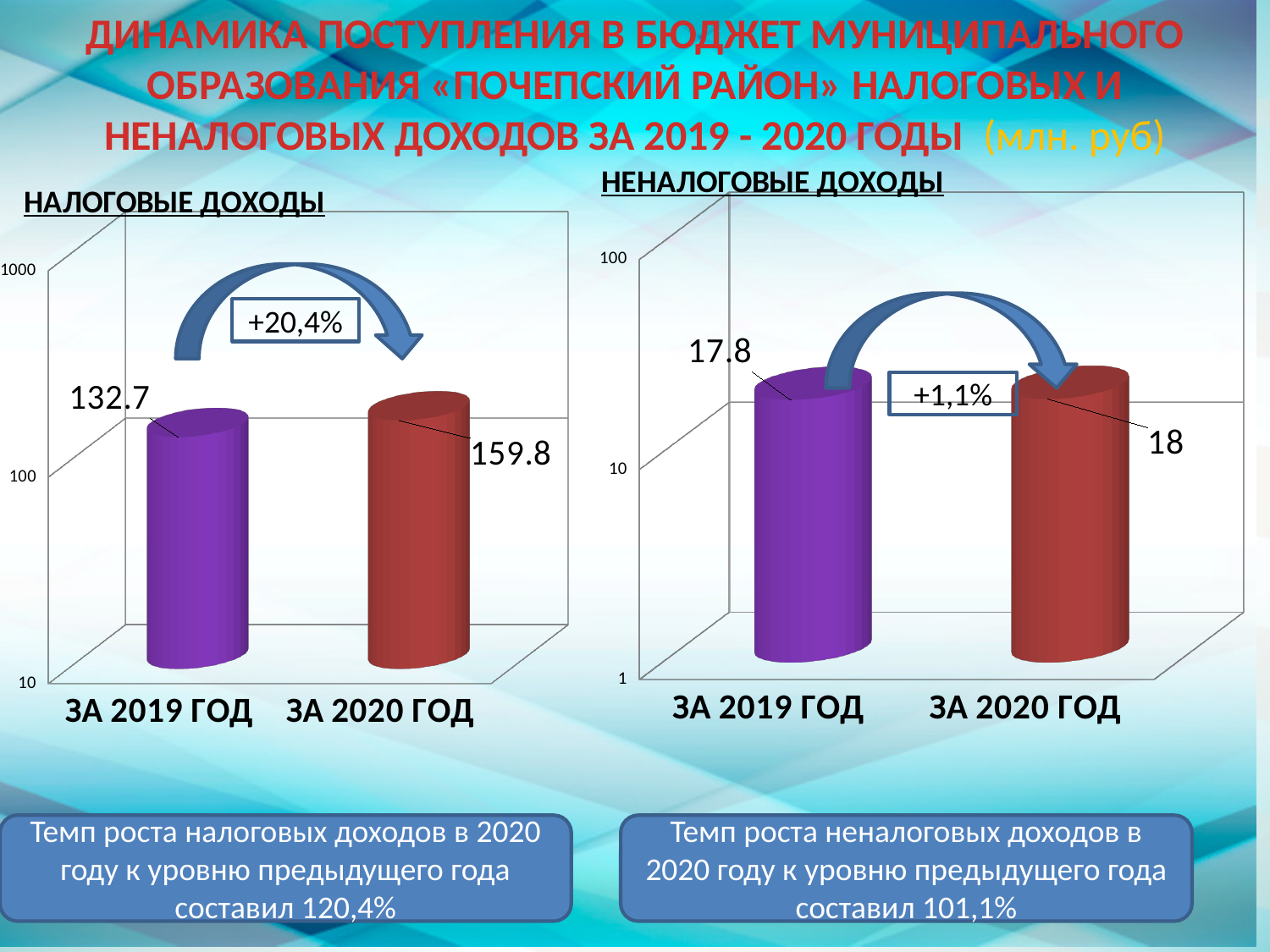
In the НЕНАЛОГОВЫЕ ДОХОДЫ chart, what is the value for ЗА 2020 ГОД? 18 How many bars are shown in the НЕНАЛОГОВЫЕ ДОХОДЫ chart? 2 In the НАЛОГОВЫЕ ДОХОДЫ chart, do the values rise or fall from 2019 to 2020? rise In the НЕНАЛОГОВЫЕ ДОХОДЫ chart, what is the difference between the values for ЗА 2020 ГОД and ЗА 2019 ГОД? 0.2 What kind of chart is the НАЛОГОВЫЕ ДОХОДЫ chart? bar chart In the НАЛОГОВЫЕ ДОХОДЫ chart, is the value for ЗА 2019 ГОД greater or less than 100? greater What percentage change is shown on the arrow in the НЕНАЛОГОВЫЕ ДОХОДЫ chart? +1,1% In the НАЛОГОВЫЕ ДОХОДЫ chart, what is the value for ЗА 2020 ГОД? 159.8 In the НАЛОГОВЫЕ ДОХОДЫ chart, which year has the higher value? ЗА 2020 ГОД In the НАЛОГОВЫЕ ДОХОДЫ chart, what is the difference between the values for ЗА 2020 ГОД and ЗА 2019 ГОД? 27.1 In the НЕНАЛОГОВЫЕ ДОХОДЫ chart, what is the value for ЗА 2019 ГОД? 17.8 In the НАЛОГОВЫЕ ДОХОДЫ chart, what is the value for ЗА 2019 ГОД? 132.7